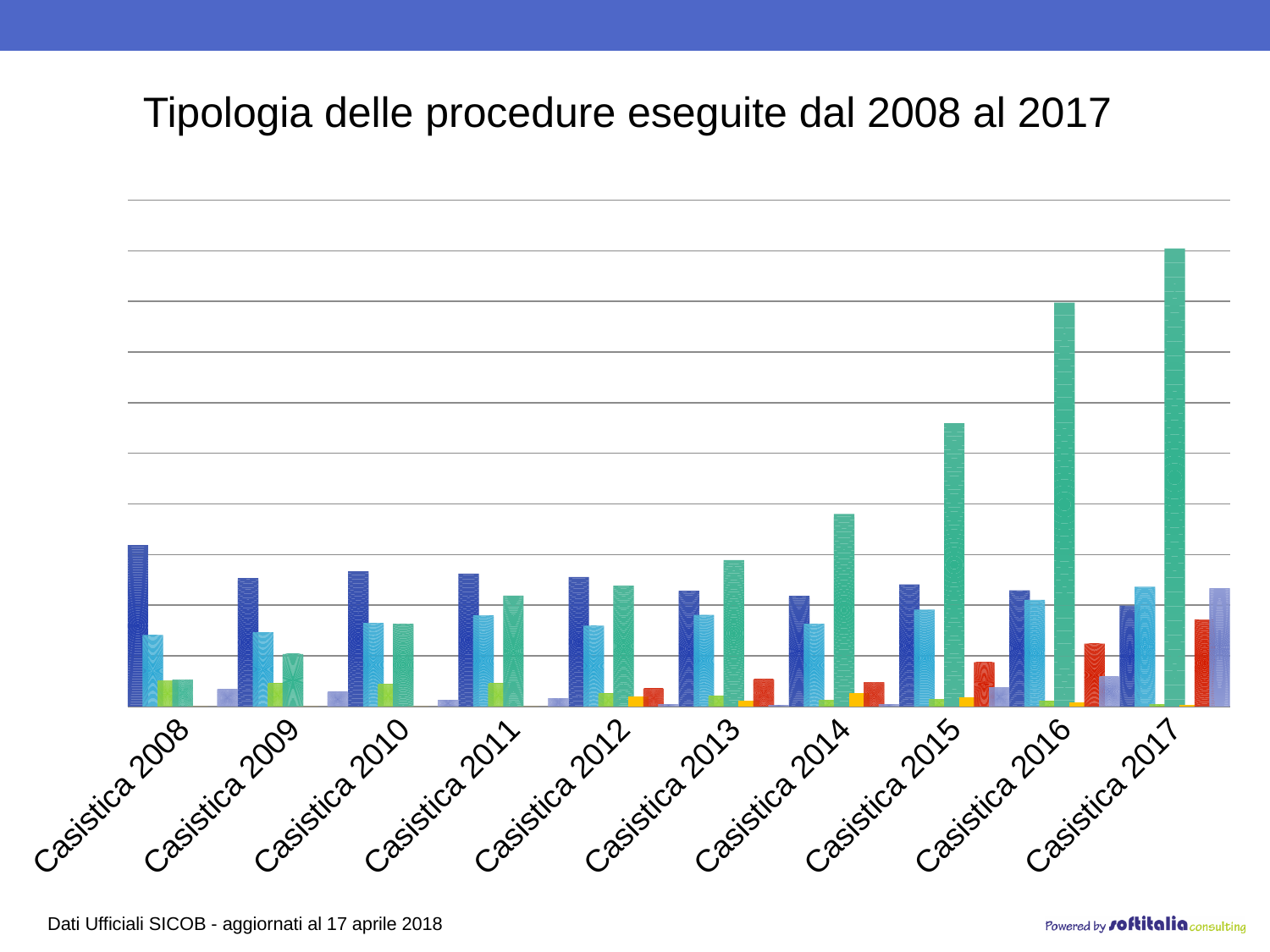
How many categories are shown along the x axis of the chart? 10 What kind of chart is shown on the slide? bar chart What is the title of the chart on the slide? Tipologia delle procedure eseguite dal 2008 al 2017 Which category has the shortest green bar? Casistica 2008 Which category has the tallest dark blue bar? Casistica 2008 Which is taller: the green bar for Casistica 2016 or the green bar for Casistica 2015? Casistica 2016 Which is taller: the dark blue bar for Casistica 2008 or the dark blue bar for Casistica 2017? Casistica 2008 What is the first category label on the x axis? Casistica 2008 Which category has the tallest green bar? Casistica 2017 Which is taller in Casistica 2017: the green bar or the dark blue bar? the green bar Does the green series rise or fall from Casistica 2008 to Casistica 2017? rise Which category contains the tallest bar in the chart? Casistica 2017